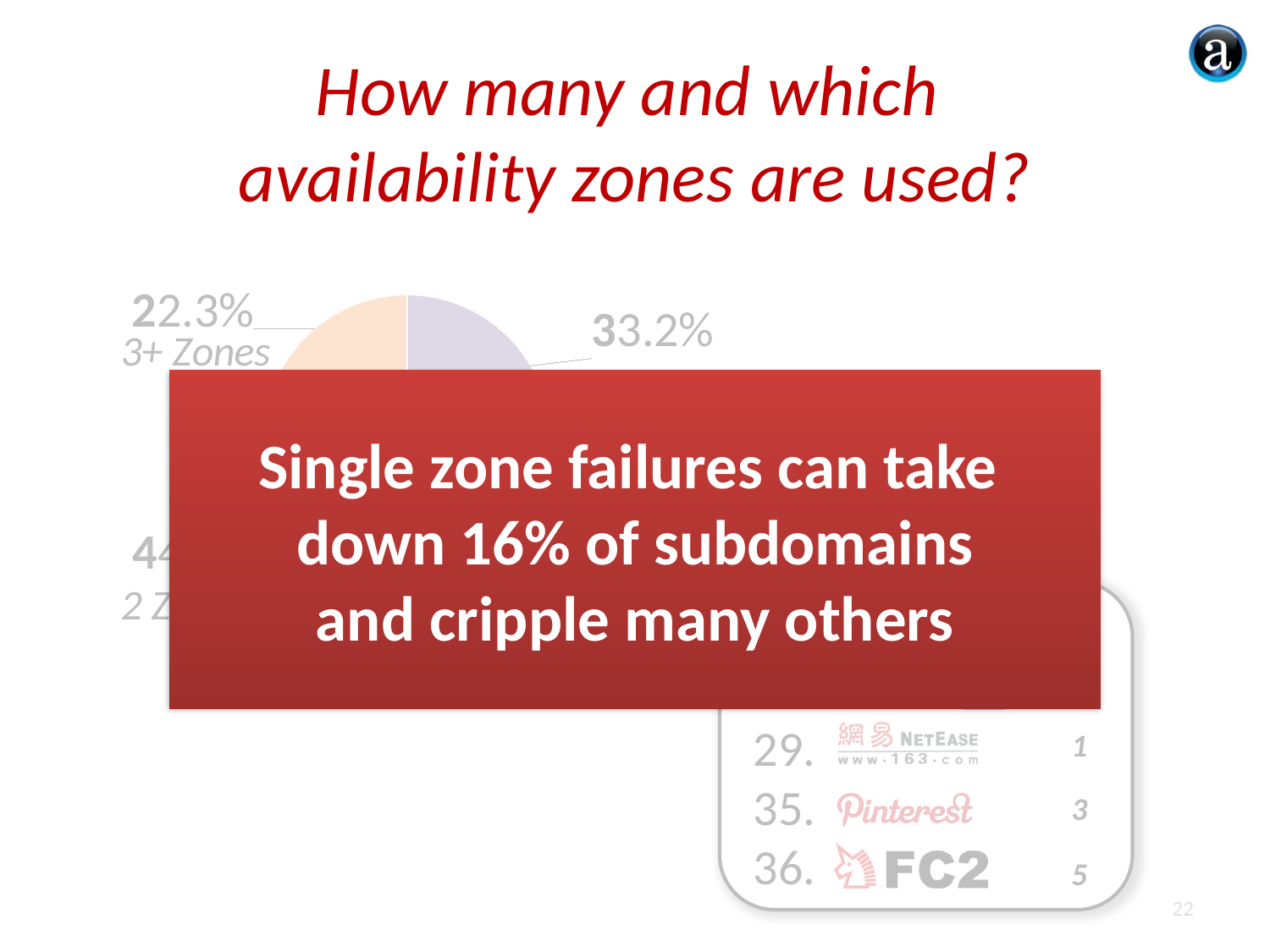
Is the share for "3+ Zones" greater or less than 25%? less What question does the slide title ask above the pie chart? How many and which availability zones are used? What is the difference between the slice labelled 33.2% and the "3+ Zones" slice? 10.9% Which is larger: the "3+ Zones" slice or the slice labelled 33.2%? the slice labelled 33.2% According to the red callout box covering the chart, what percentage of subdomains can single zone failures take down? 16% What percentage of the pie chart is labelled "3+ Zones"? 22.3% What kind of chart is shown on the slide? pie chart